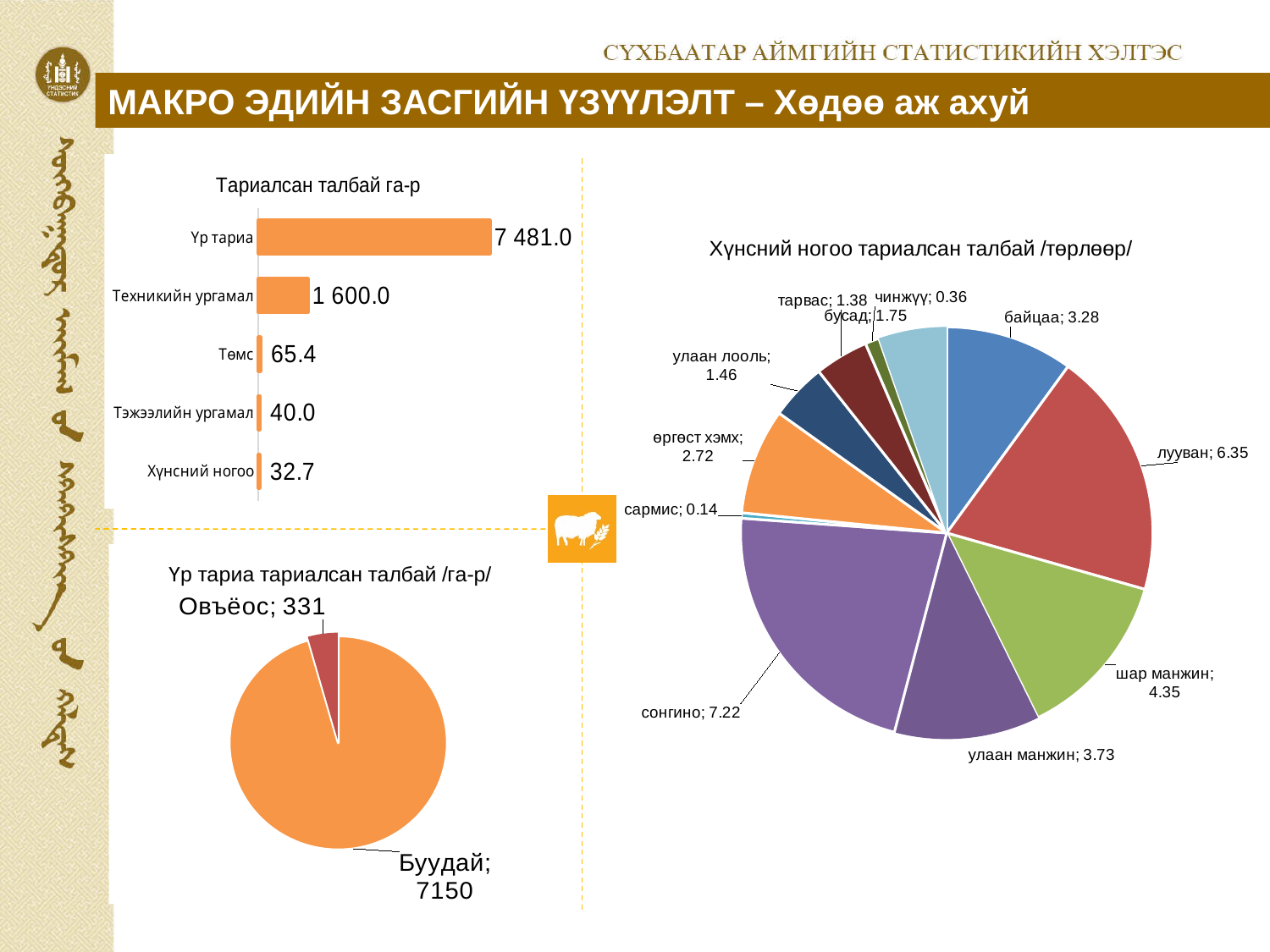
How many categories are shown in the chart titled 'Тариалсан талбай га-р'? 5 In the chart titled 'Тариалсан талбай га-р', what is the value for Төмс? 65.4 What kind of chart is the one titled 'Тариалсан талбай га-р'? bar chart In the pie chart titled 'Хүнсний ногоо тариалсан талбай /төрлөөр/', which category has the largest slice? сонгино In the pie chart titled 'Үр тариа тариалсан талбай /га-р/', what is the total of Буудай and Овъёос? 7481 In the pie chart titled 'Хүнсний ногоо тариалсан талбай /төрлөөр/', what is the value for лууван? 6.35 How many slices are in the pie chart titled 'Хүнсний ногоо тариалсан талбай /төрлөөр/'? 11 In the chart titled 'Тариалсан талбай га-р', what is the difference between Техникийн ургамал and Тэжээлийн ургамал? 1 560.0 In the chart titled 'Тариалсан талбай га-р', what is the value for Үр тариа? 7 481.0 In the pie chart titled 'Үр тариа тариалсан талбай /га-р/', what is the value for Буудай? 7150 In the pie chart titled 'Хүнсний ногоо тариалсан талбай /төрлөөр/', which is larger: шар манжин or улаан манжин? шар манжин In the chart titled 'Тариалсан талбай га-р', which category has the lowest value? Хүнсний ногоо